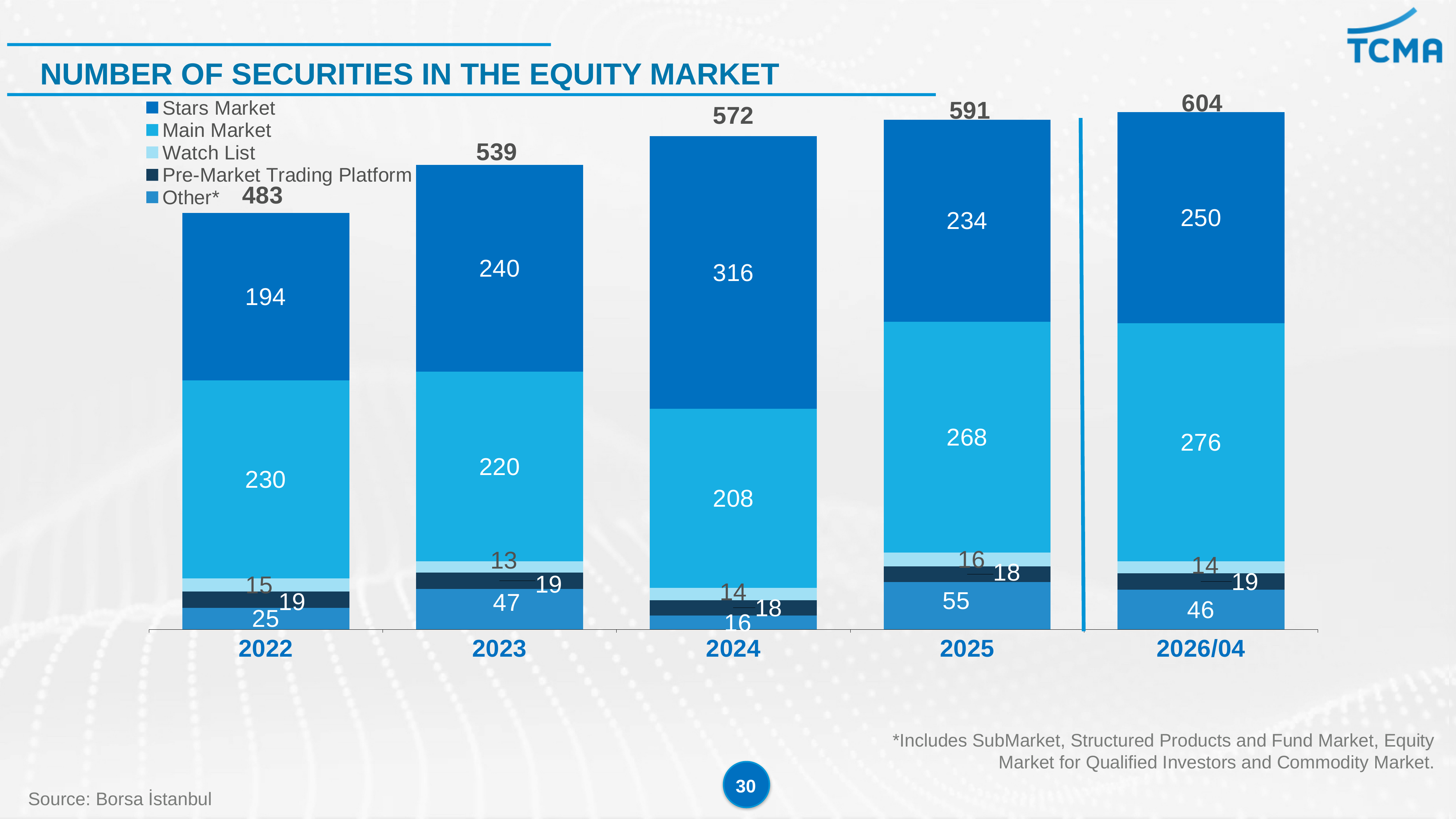
Which year has the highest total number of securities? 2026/04 What is the Stars Market value for 2024? 316 In 2025, which is larger: the Stars Market value or the Main Market value? Main Market How many series does the legend list? 5 Which year has the lowest total number of securities? 2022 What is the difference between the Stars Market values for 2024 and 2023? 76 How many years (categories) are shown on the x axis? 5 What is the Other* value for 2025? 55 What is the Main Market value for 2026/04? 276 What type of chart is shown on the slide? Stacked bar chart Do the total values rise or fall from 2022 to 2026/04? Rise What is the total number of securities shown for 2023? 539